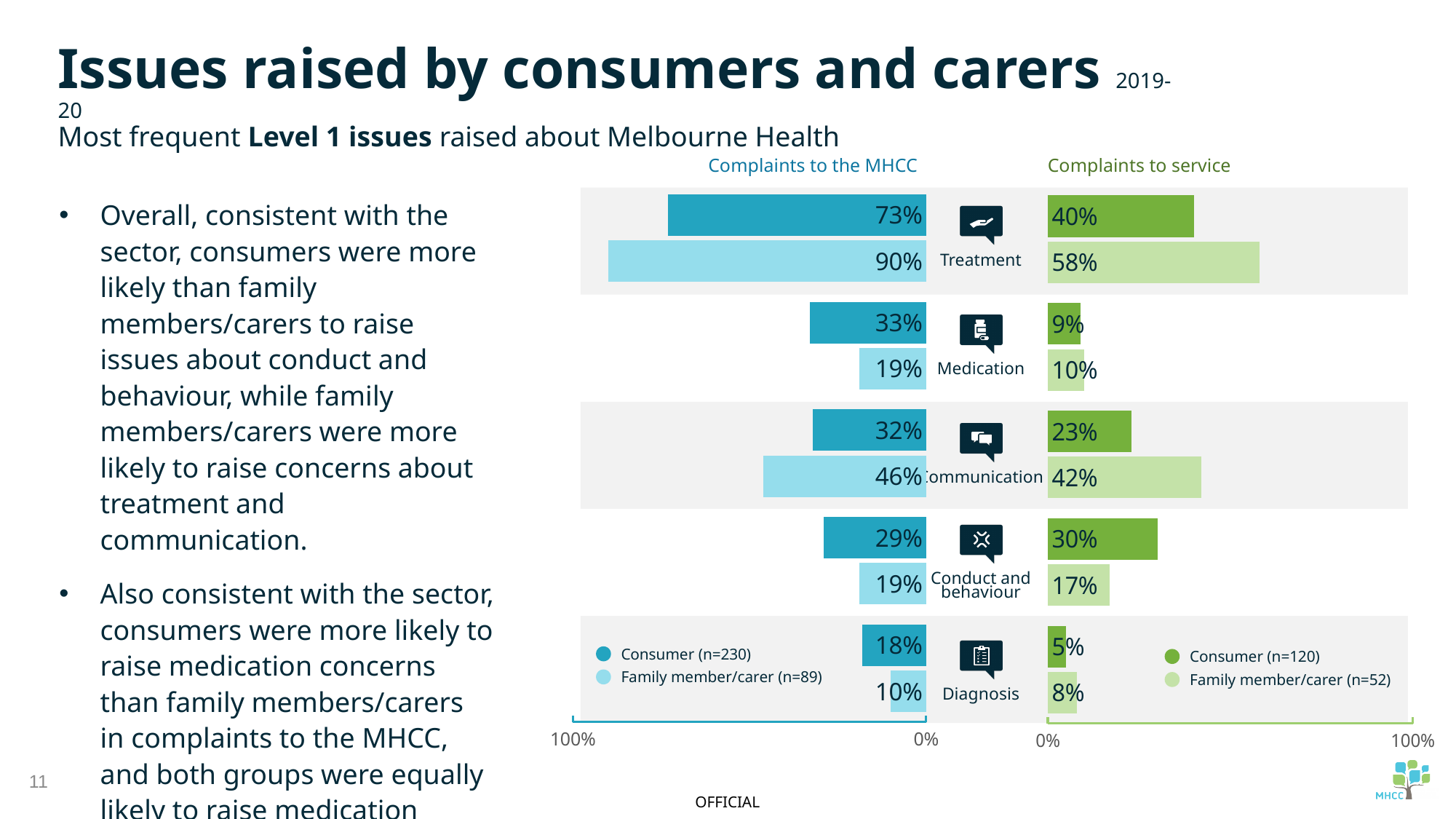
In the 'Complaints to the MHCC' chart, which is larger for Medication: the consumer percentage or the family member/carer percentage? Consumer In the 'Complaints to service' chart, which is larger for Conduct and behaviour: the consumer percentage or the family member/carer percentage? Consumer How many series does the legend of the 'Complaints to service' chart list? 2 In the 'Complaints to the MHCC' chart, what is the difference between the family member/carer and consumer percentages for Treatment? 17% In the 'Complaints to service' chart, which issue has the highest percentage for consumers? Treatment In the 'Complaints to the MHCC' chart, what percentage of consumer complaints were about Treatment? 73% In the 'Complaints to the MHCC' chart, which issue has the lowest percentage for family members/carers? Diagnosis How many issue categories are shown in the 'Complaints to the MHCC' chart? 5 In the 'Complaints to service' chart, what percentage of family member/carer complaints were about Communication? 42% In the 'Complaints to service' chart, what is the difference between the family member/carer and consumer percentages for Communication? 19% In the 'Complaints to the MHCC' chart, what percentage of family member/carer complaints were about Diagnosis? 10% What type of chart is the 'Complaints to the MHCC' chart? Bar chart